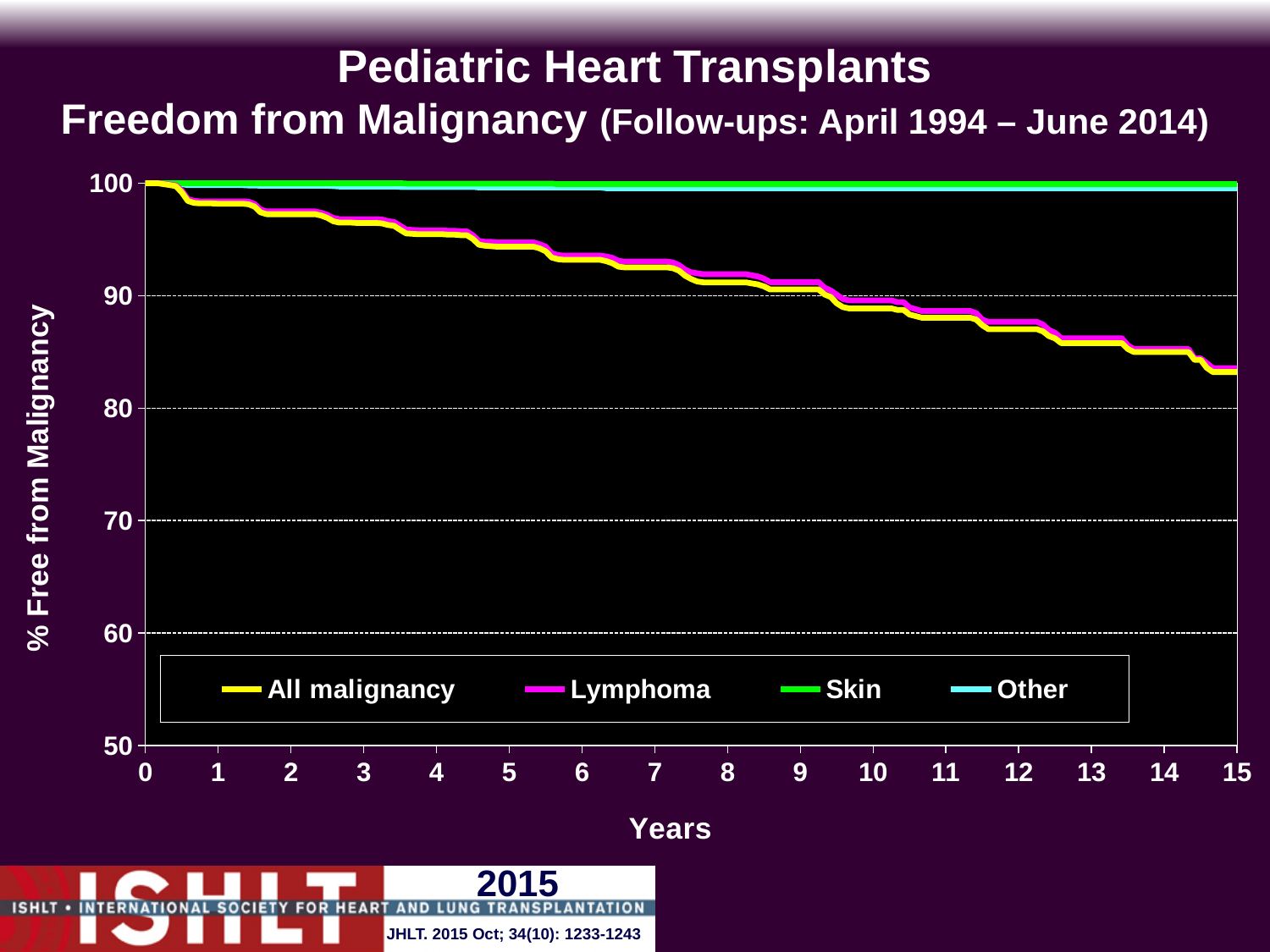
Is the value for All malignancy at 15 years greater or less than 80? greater Which colour represents Lymphoma in the legend? magenta Does the All malignancy line rise or fall as years increase? fall At 15 years, which is higher: Skin or All malignancy? Skin Is the value for Lymphoma at 12 years greater or less than 90? less Is the value for All malignancy at 5 years greater or less than 90? greater At 15 years, which is lower: Other or Lymphoma? Lymphoma What kind of chart is shown on the slide? line chart What is the label of the y axis? % Free from Malignancy How many series does the legend list? 4